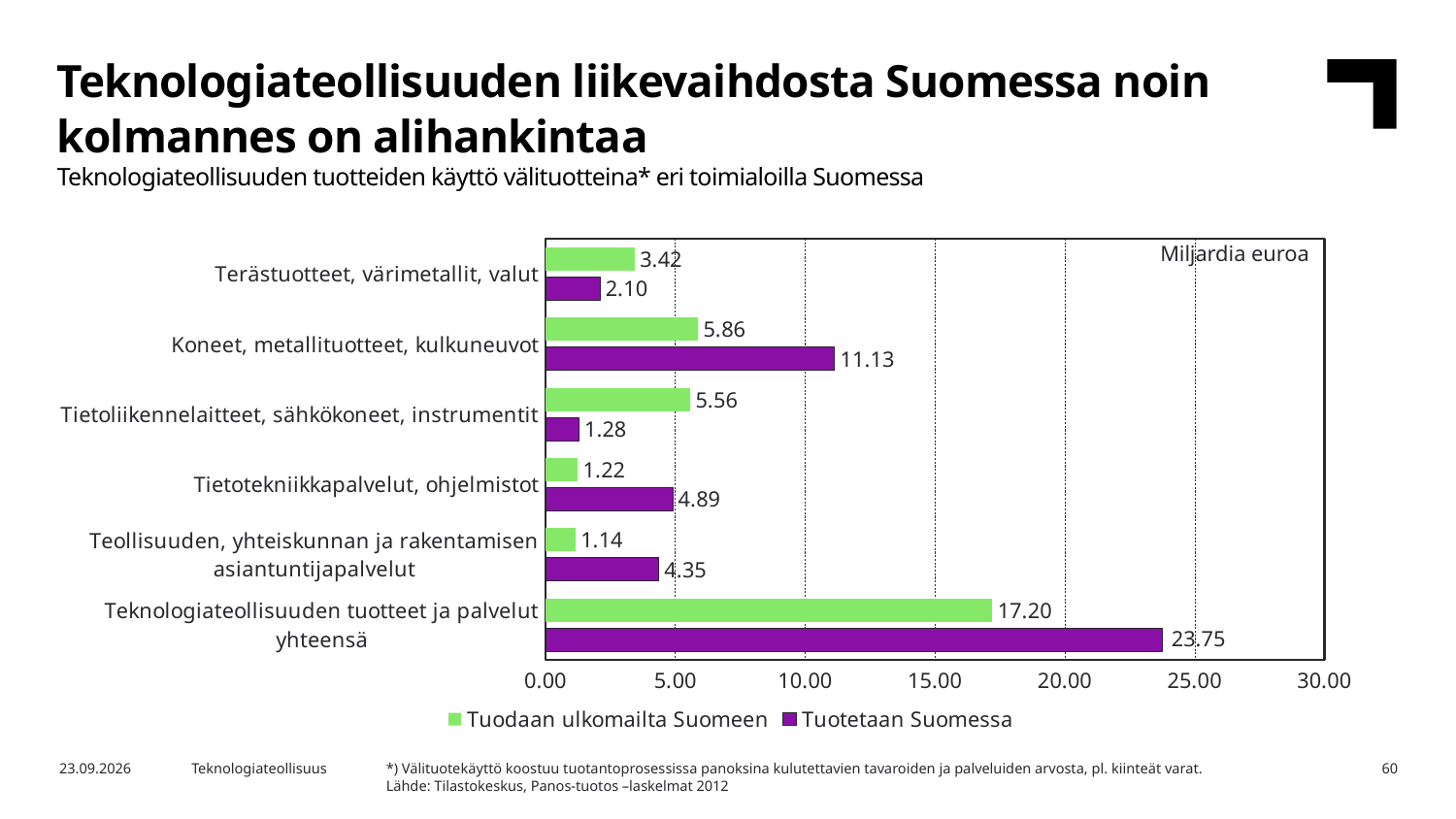
How many series does the legend list? 2 What type of chart is shown on the slide? Bar chart What is the value of "Tuotetaan Suomessa" for Teknologiateollisuuden tuotteet ja palvelut yhteensä? 23.75 What is the value of "Tuodaan ulkomailta Suomeen" for Tietoliikennelaitteet, sähkökoneet, instrumentit? 5.56 What is the difference between the "Tuotetaan Suomessa" and "Tuodaan ulkomailta Suomeen" values for Koneet, metallituotteet, kulkuneuvot? 5.27 What is the value of "Tuotetaan Suomessa" for Koneet, metallituotteet, kulkuneuvot? 11.13 How many categories are shown on the chart? 6 For Terästuotteet, värimetallit, valut, which is larger: "Tuodaan ulkomailta Suomeen" or "Tuotetaan Suomessa"? Tuodaan ulkomailta Suomeen What unit is indicated in the top right corner of the chart? Miljardia euroa Is the "Tuotetaan Suomessa" value for Tietotekniikkapalvelut, ohjelmistot greater or less than 5.00? less Which category has the lowest "Tuodaan ulkomailta Suomeen" value? Teollisuuden, yhteiskunnan ja rakentamisen asiantuntijapalvelut Excluding the total row (yhteensä), which category has the highest "Tuotetaan Suomessa" value? Koneet, metallituotteet, kulkuneuvot